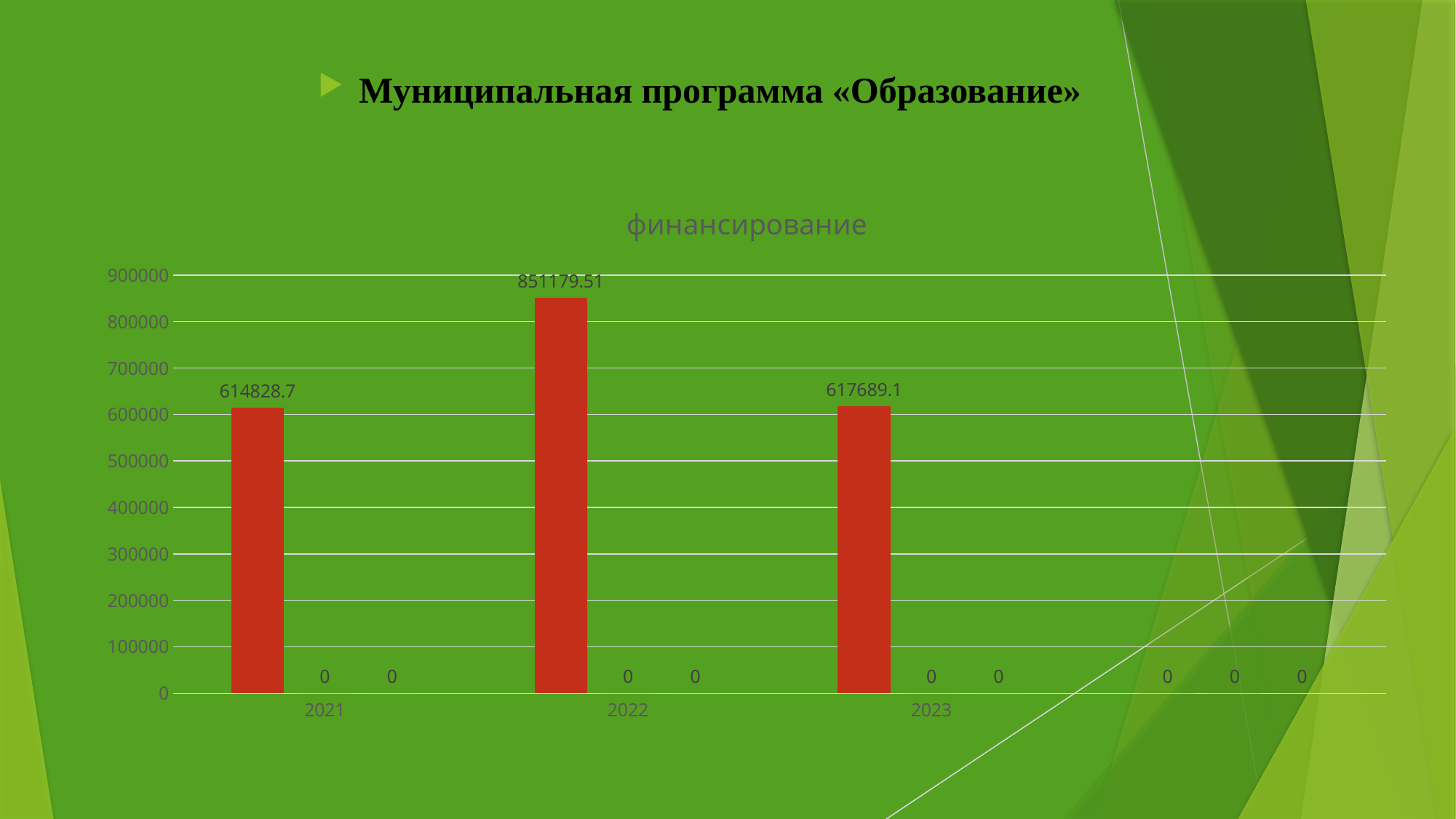
What is the difference between the values for 2022 and 2021? 236350.81 Which year has the highest value in the chart? 2022 Which year has the lowest non-zero value in the chart? 2021 What is the difference between the values for 2023 and 2021? 2860.4 What is the title of the chart? финансирование Which is larger, the value for 2021 or the value for 2023? 2023 What is the value for 2021 in the chart? 614828.7 What kind of chart is shown on the slide? bar chart Is the value for 2023 greater or less than 700000? less What is the value for 2023 in the chart? 617689.1 Is the value for 2022 greater or less than 800000? greater What is the value for 2022 in the chart? 851179.51